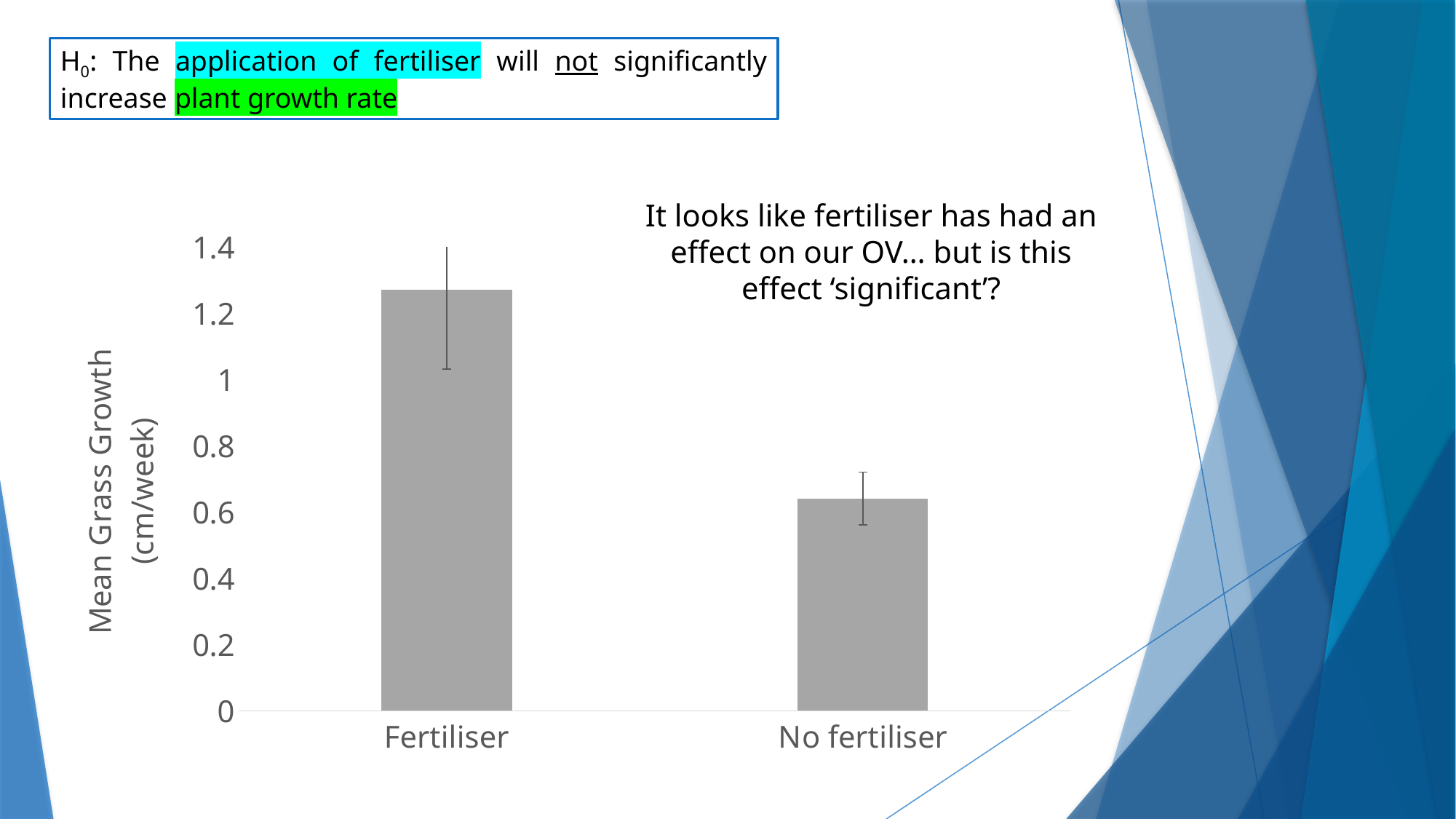
Is the value for No fertiliser greater or less than 0.8? less What is the label of the y axis? Mean Grass Growth (cm/week) Is the value for Fertiliser greater or less than 1.2? greater Is the value for Fertiliser greater or less than 1.4? less Which is larger, the value for Fertiliser or the value for No fertiliser? Fertiliser Which category has the highest mean grass growth? Fertiliser Which category has the lowest mean grass growth? No fertiliser What kind of chart is shown on the slide? bar chart How many categories are plotted on the x axis? 2 What is the highest tick value shown on the y axis? 1.4